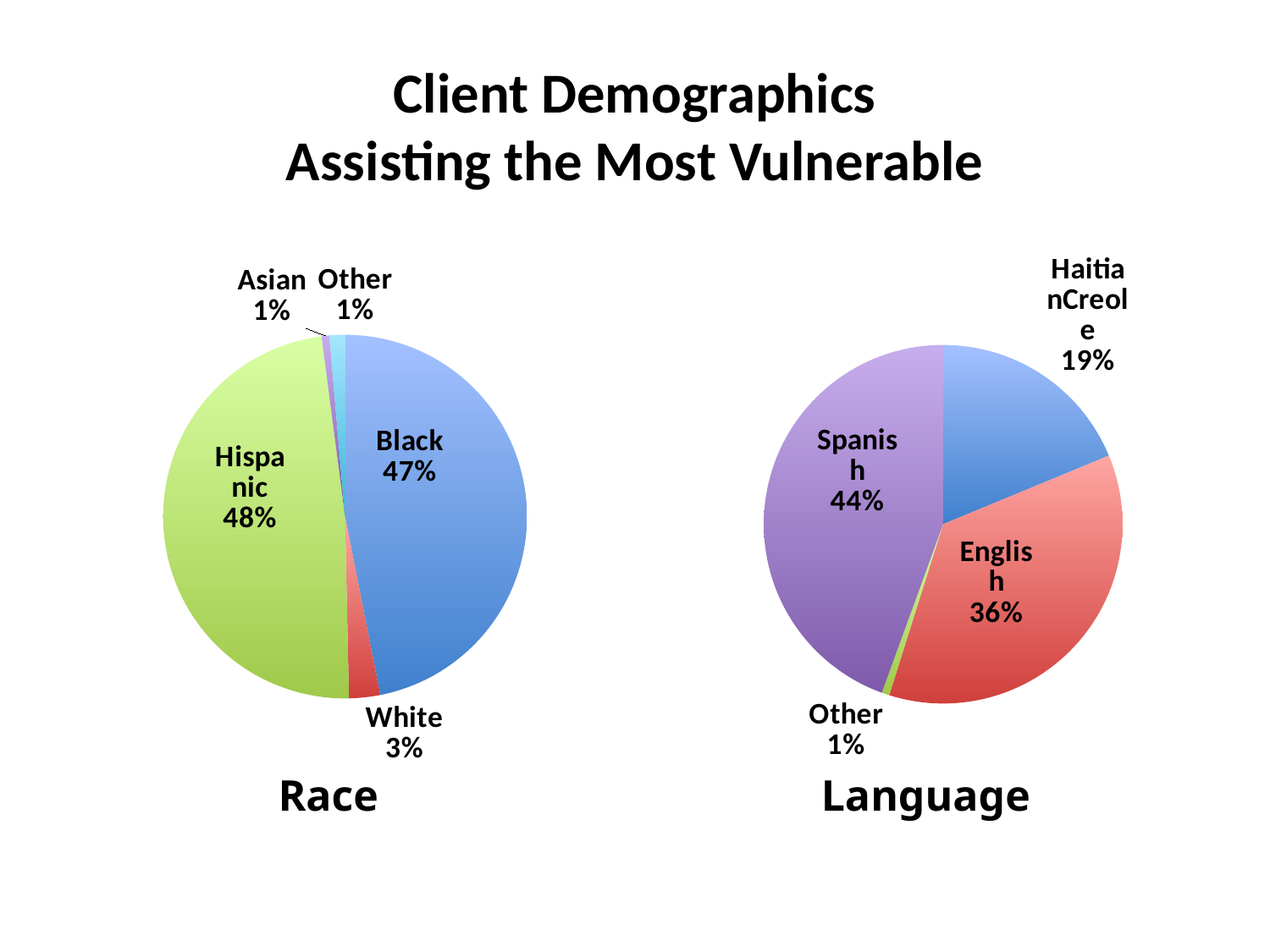
In the Race pie chart, what share of clients are White? 3% In the Language pie chart, which language has the largest share? Spanish In the Language pie chart, which language has the smallest share? Other How many slices does the Language pie chart have? 4 In the Language pie chart, what is the difference between the Spanish and English shares? 8% In the Race pie chart, which is larger, the White share or the Asian share? White In the Race pie chart, what share of clients are Hispanic? 48% In the Race pie chart, what share of clients are Black? 47% In the Language pie chart, what share of clients speak Haitian Creole? 19% How many slices does the Race pie chart have? 5 In the Language pie chart, what share of clients speak Spanish? 44% What type of chart is used for the Language chart? Pie chart